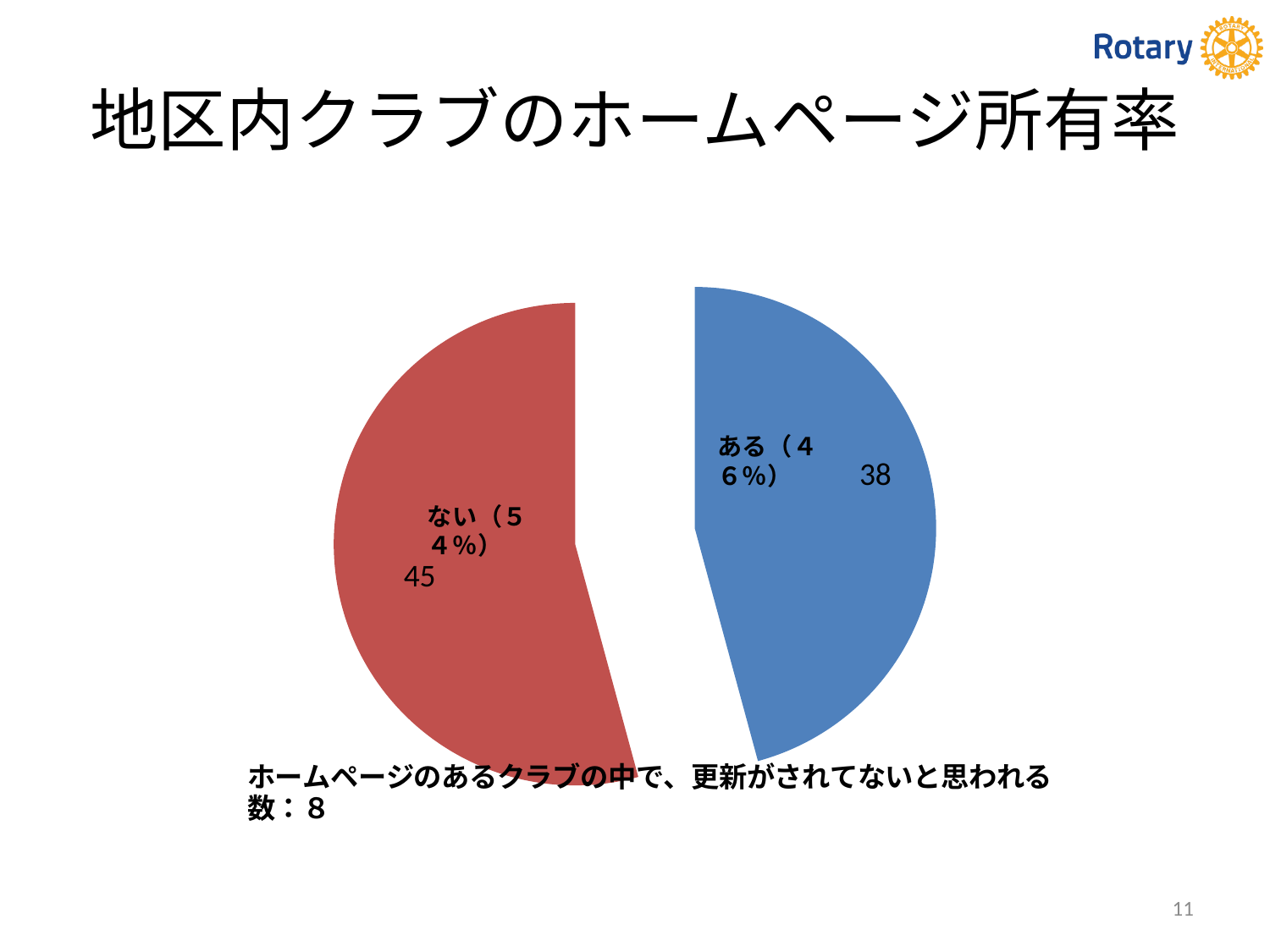
Which slice is the smallest? ある What kind of chart is shown on the slide? pie chart What is the total of the two slices in the pie chart? 83 What is the title of the slide containing the pie chart? 地区内クラブのホームページ所有率 Which is larger, the value for ある or the value for ない? ない How many slices does the pie chart have? 2 Which slice is the largest? ない What percentage share does the ない slice have? 54% What is the difference between the value for ない and the value for ある? 7 What is the value for the ある slice? 38 What percentage share does the ある slice have? 46% What is the value for the ない slice? 45